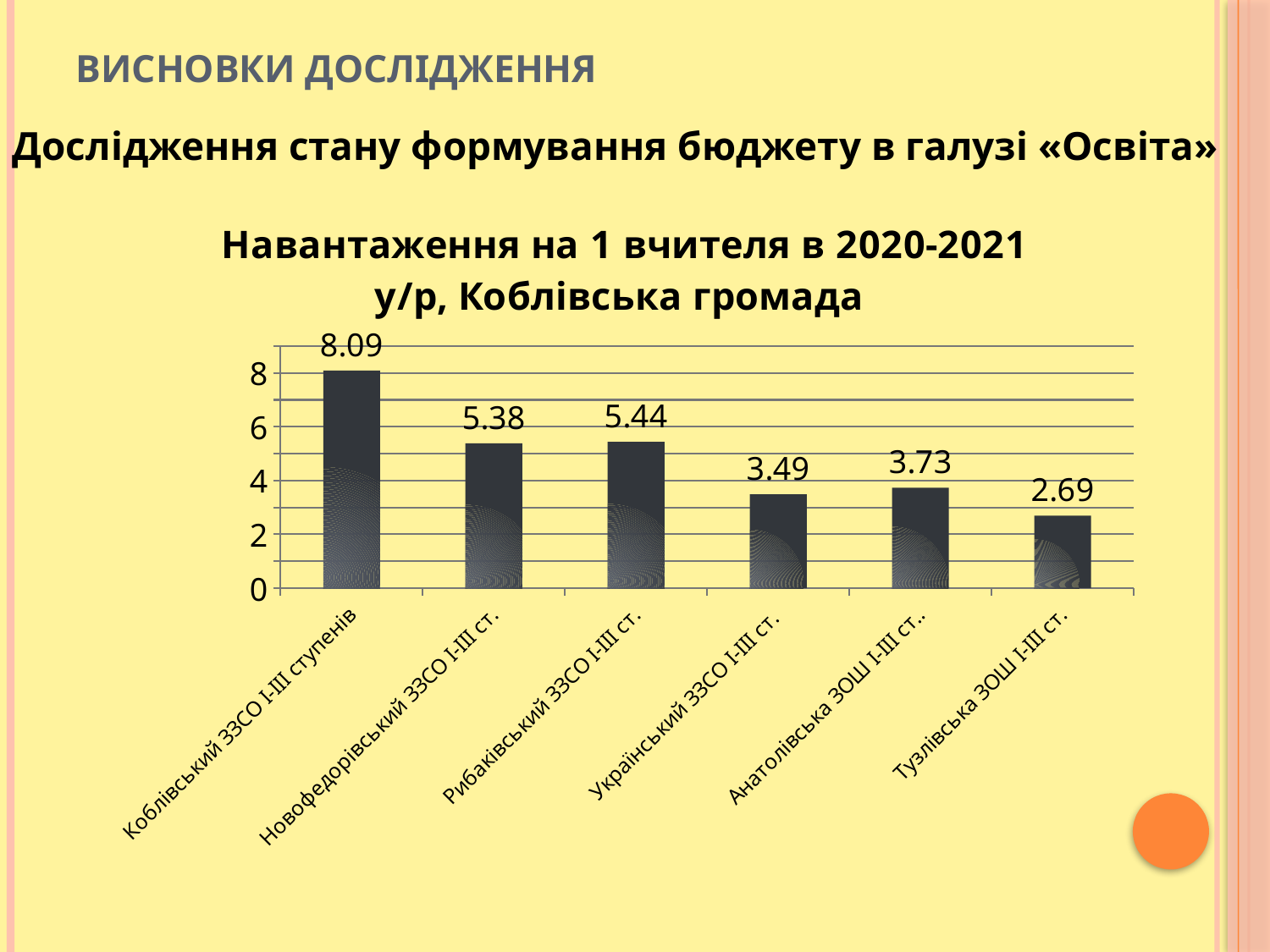
What is the value for Український ЗЗСО І-ІІІ ст.? 3.49 What is the value for Тузлівська ЗОШ І-ІІІ ст.? 2.69 Which school has the lowest value? Тузлівська ЗОШ І-ІІІ ст. Which is larger, the value for Анатолівська ЗОШ І-ІІІ ст. or the value for Український ЗЗСО І-ІІІ ст.? Анатолівська ЗОШ І-ІІІ ст. What is the difference between the values for Рибаківський ЗЗСО І-ІІІ ст. and Новофедорівський ЗЗСО І-ІІІ ст.? 0.06 Which school has the highest value? Коблівський ЗЗСО І-ІІІ ступенів What is the title of the chart? Навантаження на 1 вчителя в 2020-2021 у/р, Коблівська громада Is the value for Новофедорівський ЗЗСО І-ІІІ ст. greater or less than 6? less What is the difference between the values for Коблівський ЗЗСО І-ІІІ ступенів and Тузлівська ЗОШ І-ІІІ ст.? 5.40 What kind of chart is shown on the slide? bar chart What is the value for Коблівський ЗЗСО І-ІІІ ступенів? 8.09 How many schools are shown on the chart? 6